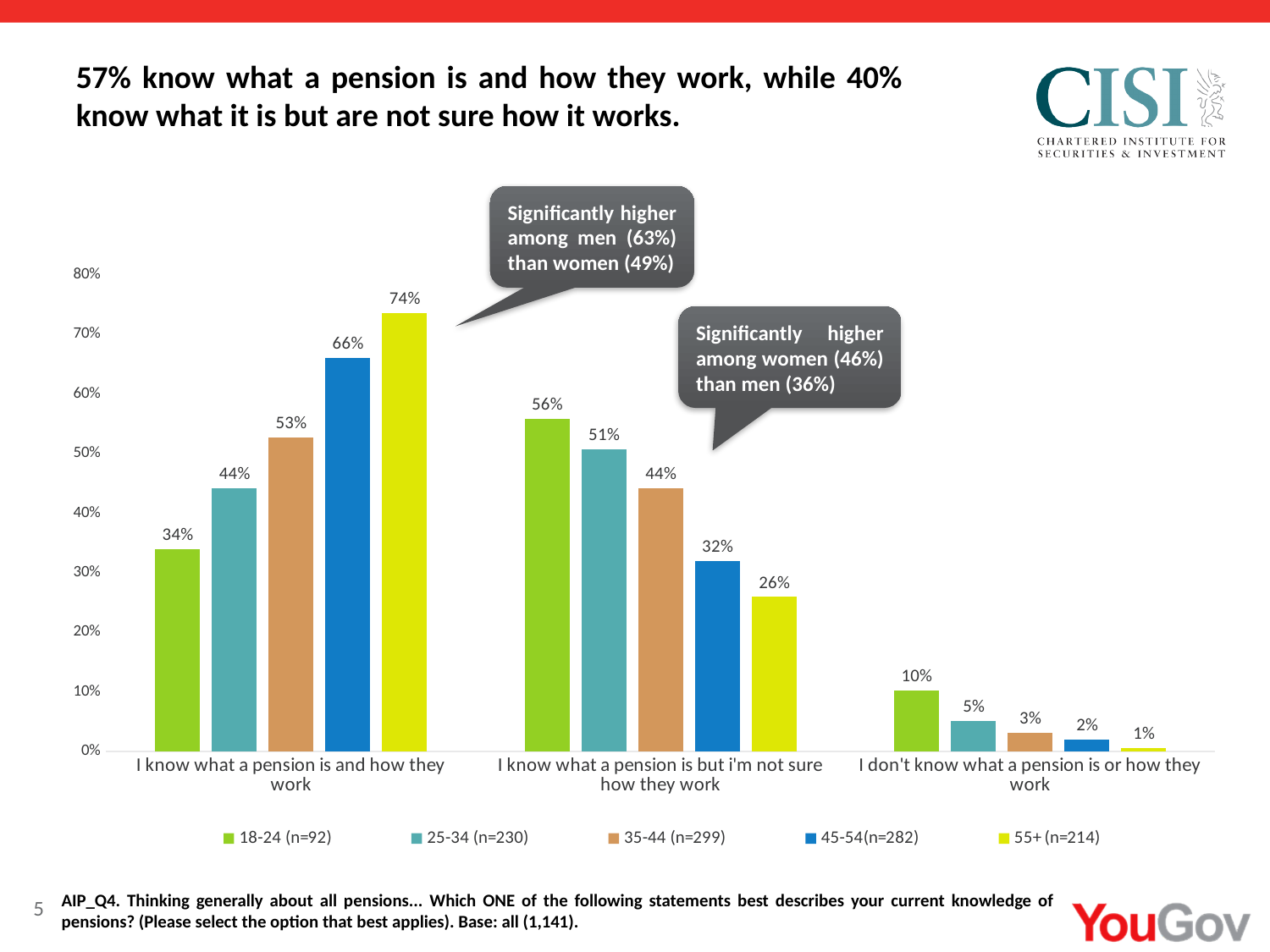
How many categories are shown on the x axis? 3 Which age group has the highest value for 'I know what a pension is and how they work'? 55+ (n=214) Across the age groups from 18-24 to 55+, do the values for 'I know what a pension is but i'm not sure how they work' rise or fall? Fall What percentage of the 18-24 (n=92) group say they know what a pension is but are not sure how they work? 56% How many series does the legend list? 5 What is the difference between the 55+ (n=214) and 18-24 (n=92) values for 'I know what a pension is and how they work'? 40 percentage points What percentage of the 55+ (n=214) group say they know what a pension is and how they work? 74% What percentage of the 35-44 (n=299) group say they don't know what a pension is or how they work? 3% Which age group has the lowest value for 'I don't know what a pension is or how they work'? 55+ (n=214) What kind of chart is shown on the slide? Bar chart According to the callout, what percentage of men know what a pension is and how they work? 63% For 'I know what a pension is but i'm not sure how they work', which is larger: the 25-34 (n=230) value or the 45-54(n=282) value? 25-34 (n=230)